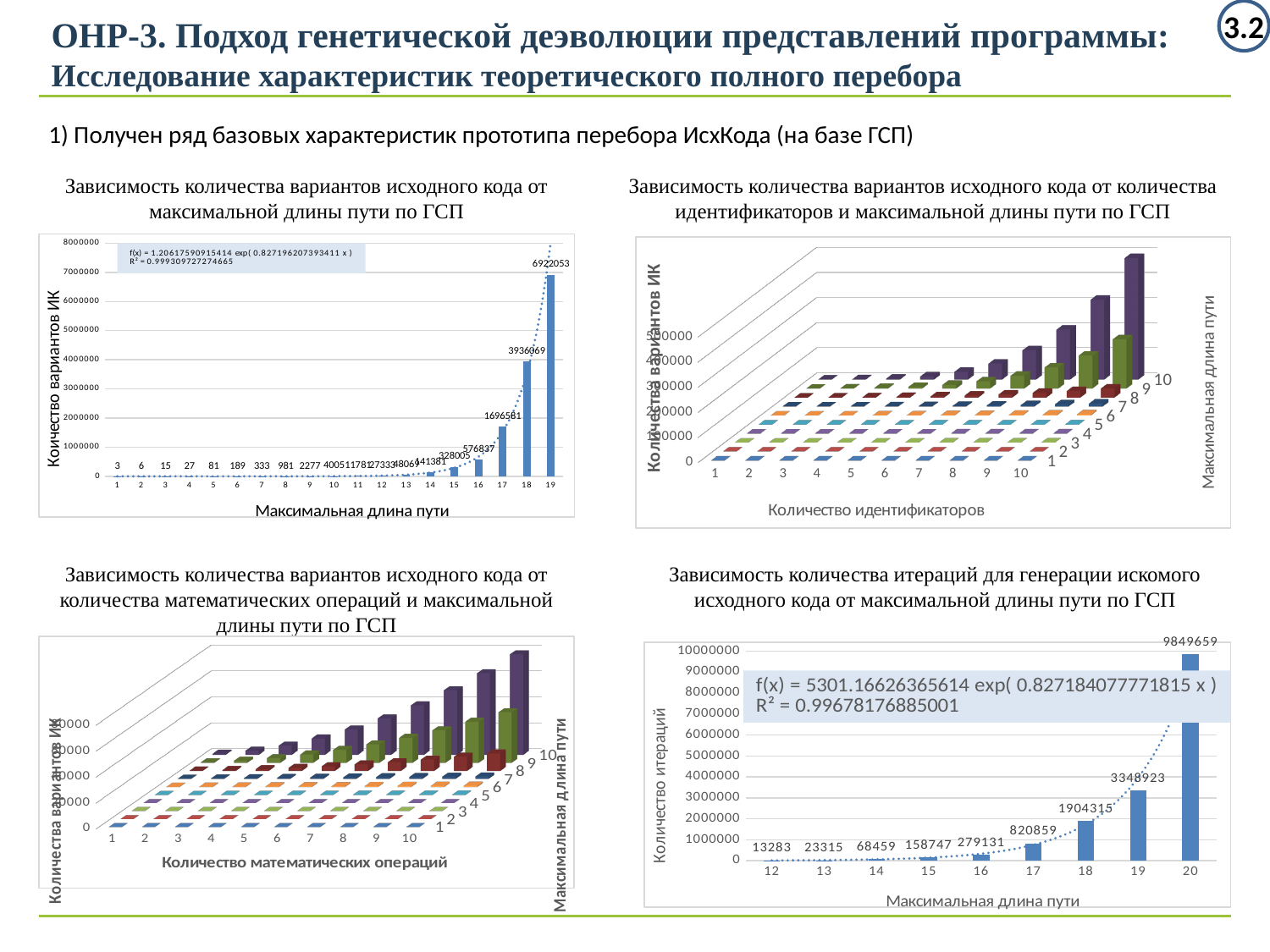
In the bottom-right chart (Зависимость количества итераций...), how many maximum path length categories are shown on the x axis? 9 In the bottom-right chart (Зависимость количества итераций...), what is the value for maximum path length 20? 9849659 In the top-left chart (Зависимость количества вариантов исходного кода от максимальной длины пути по ГСП), which is larger: the value for path length 16 or path length 15? path length 16 What kind of chart is the top-right chart (Зависимость количества вариантов исходного кода от количества идентификаторов и максимальной длины пути по ГСП)? 3D bar chart In the top-left chart (Зависимость количества вариантов исходного кода от максимальной длины пути по ГСП), is the value for path length 18 greater or less than 3000000? greater In the bottom-right chart (Зависимость количества итераций...), what is the difference between the values for path length 19 and path length 18? 1444608 In the top-left chart (Зависимость количества вариантов исходного кода от максимальной длины пути по ГСП), what is the value for maximum path length 17? 1696581 In the bottom-right chart (Зависимость количества итераций...), which maximum path length has the highest number of iterations? 20 In the bottom-right chart (Зависимость количества итераций...), what is the value for maximum path length 18? 1904315 In the top-left chart (Зависимость количества вариантов исходного кода от максимальной длины пути по ГСП), what is the value for maximum path length 19? 6922053 In the bottom-right chart (Зависимость количества итераций...), what is the value for maximum path length 12? 13283 In the bottom-right chart (Зависимость количества итераций...), do the values rise or fall as the maximum path length increases? rise